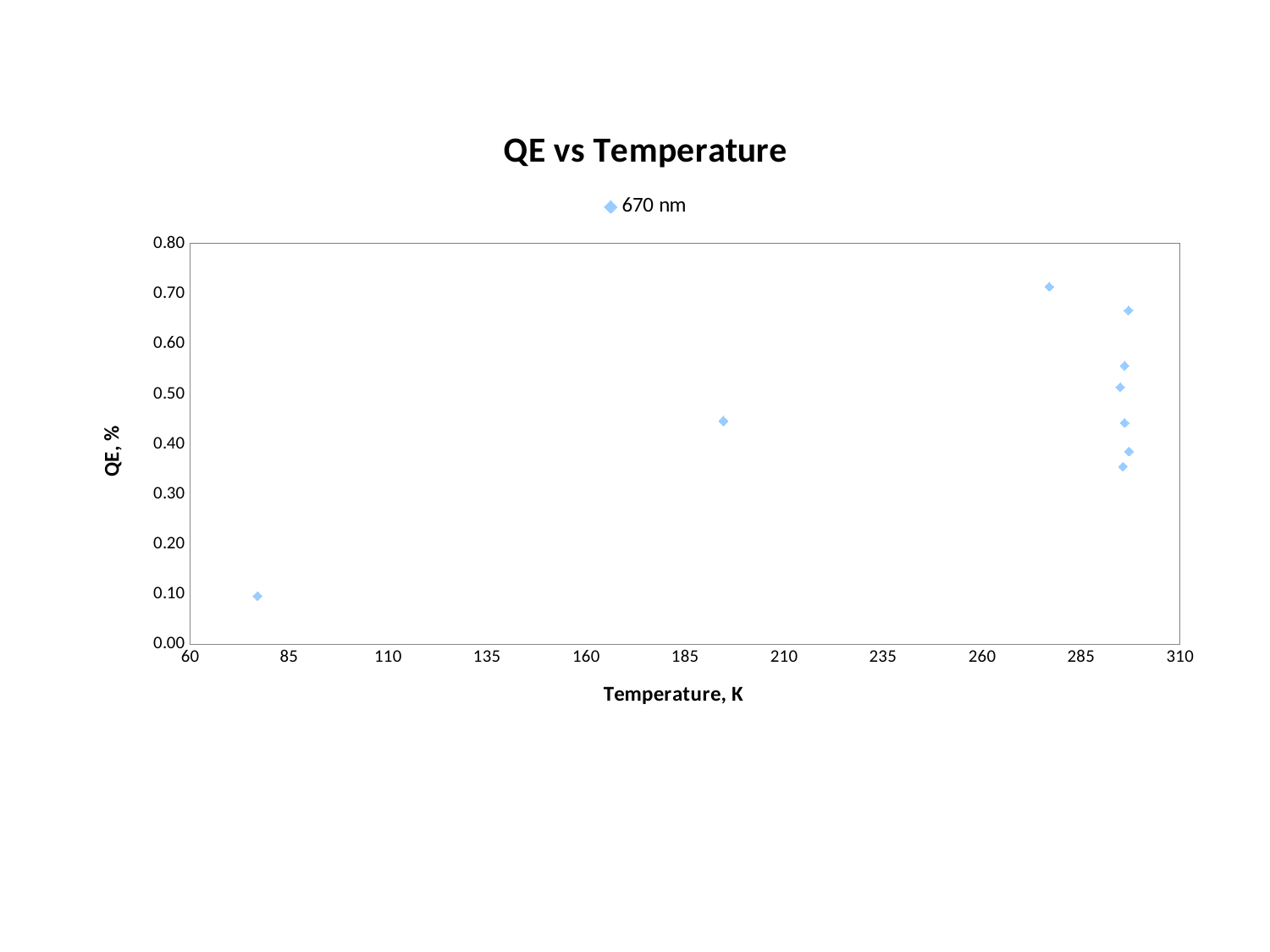
What is the title of the chart? QE vs Temperature What kind of chart is shown on the slide? scatter chart Does QE generally rise or fall as temperature increases along the x axis? rise Is the QE value for the point near 195 K greater or less than 0.30? greater Is the QE value for the lowest point in the cluster near 295 K greater or less than 0.30? greater How many data points are plotted in the cluster near 295 K? 6 What is the name of the series shown in the legend? 670 nm Which has the higher QE: the point near 77 K or the point near 195 K? the point near 195 K Is the QE value for the highest point on the chart greater or less than 0.60? greater How many series does the legend list? 1